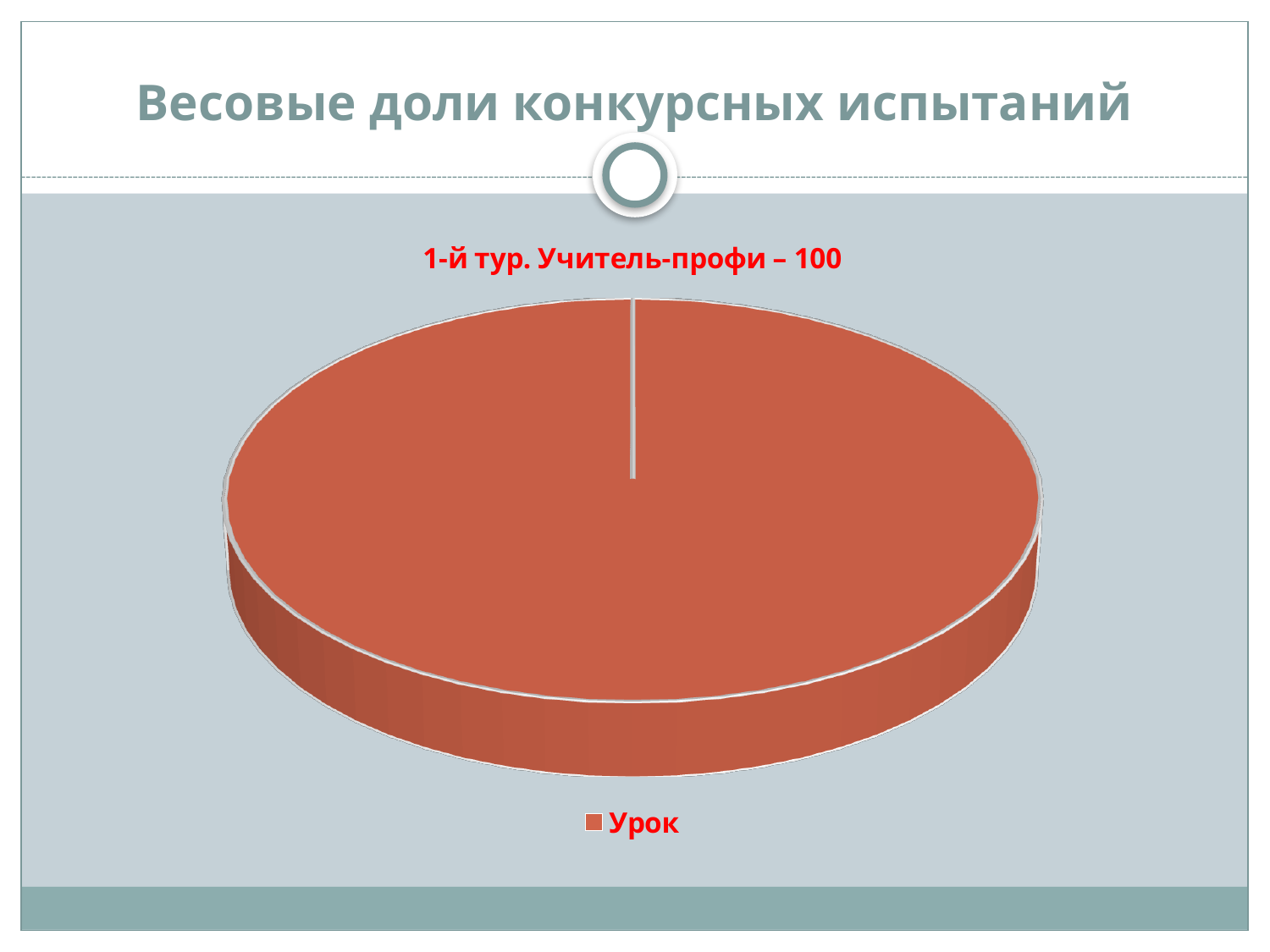
How many slices does the pie chart have? 1 What is the title of the pie chart? 1-й тур. Учитель-профи – 100 Which category has the largest slice in the pie chart? Урок How many entries does the chart legend list? 1 What category is listed in the chart legend? Урок What share of the pie does the slice Урок take up? 100% What kind of chart is shown on the slide? pie chart